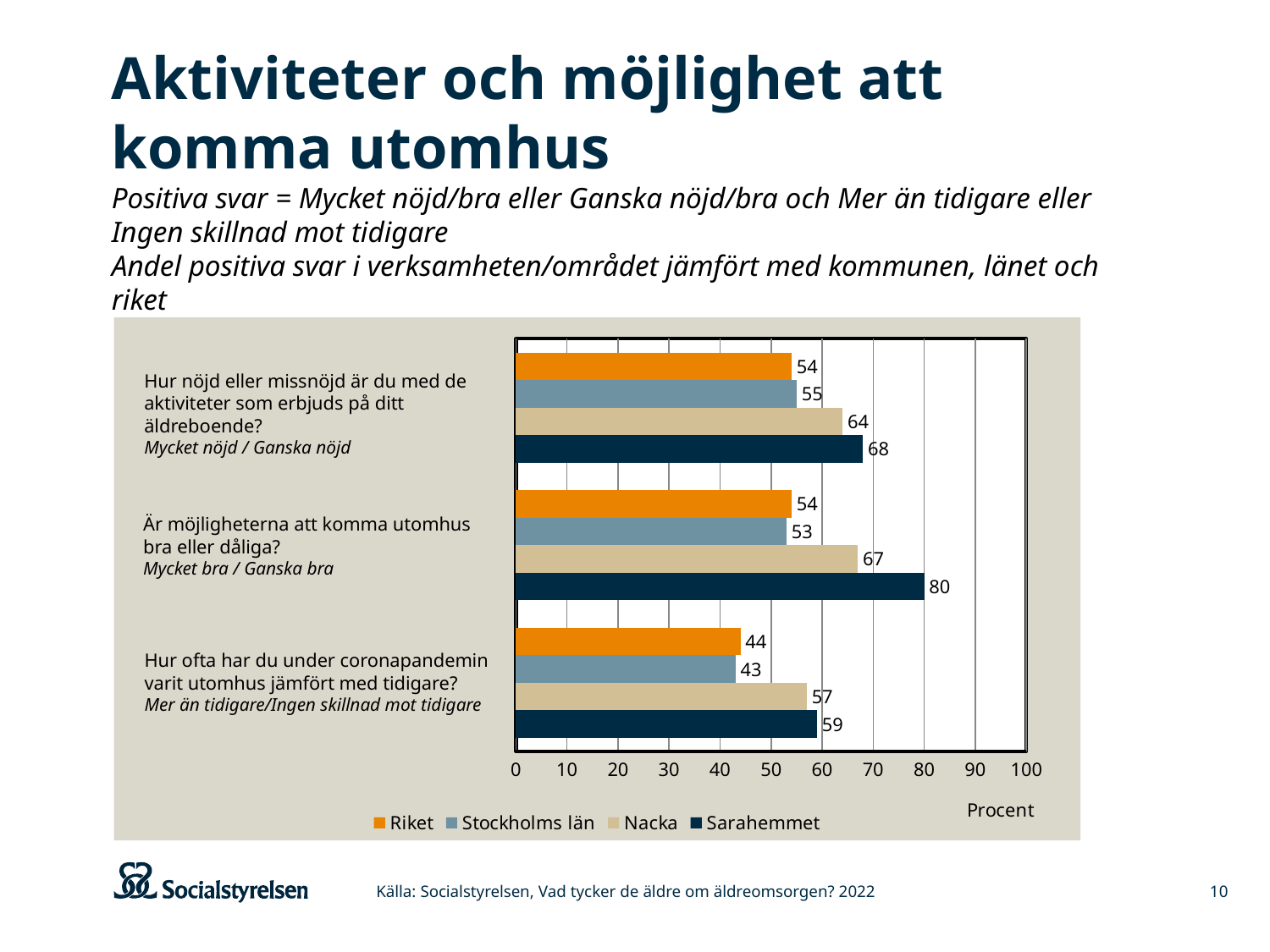
What is the difference between Nacka and Stockholms län on the question "Hur ofta har du under coronapandemin varit utomhus jämfört med tidigare?"? 14 On the question "Hur nöjd eller missnöjd är du med de aktiviteter som erbjuds på ditt äldreboende?", which is larger: Nacka or Sarahemmet? Sarahemmet How many series does the legend list? 4 What kind of chart is shown on the slide? Bar chart What is the value for Stockholms län on the question "Hur ofta har du under coronapandemin varit utomhus jämfört med tidigare?"? 43 What is the value for Nacka on the question "Hur nöjd eller missnöjd är du med de aktiviteter som erbjuds på ditt äldreboende?"? 64 What is the value for Riket on the question "Är möjligheterna att komma utomhus bra eller dåliga?"? 54 What is the value for Sarahemmet on the question "Är möjligheterna att komma utomhus bra eller dåliga?"? 80 Which series has the highest value on the question "Är möjligheterna att komma utomhus bra eller dåliga?"? Sarahemmet What is the difference between Sarahemmet and Riket on the question "Är möjligheterna att komma utomhus bra eller dåliga?"? 26 Which series has the lowest value on the question "Hur ofta har du under coronapandemin varit utomhus jämfört med tidigare?"? Stockholms län How many question categories are shown on the chart? 3